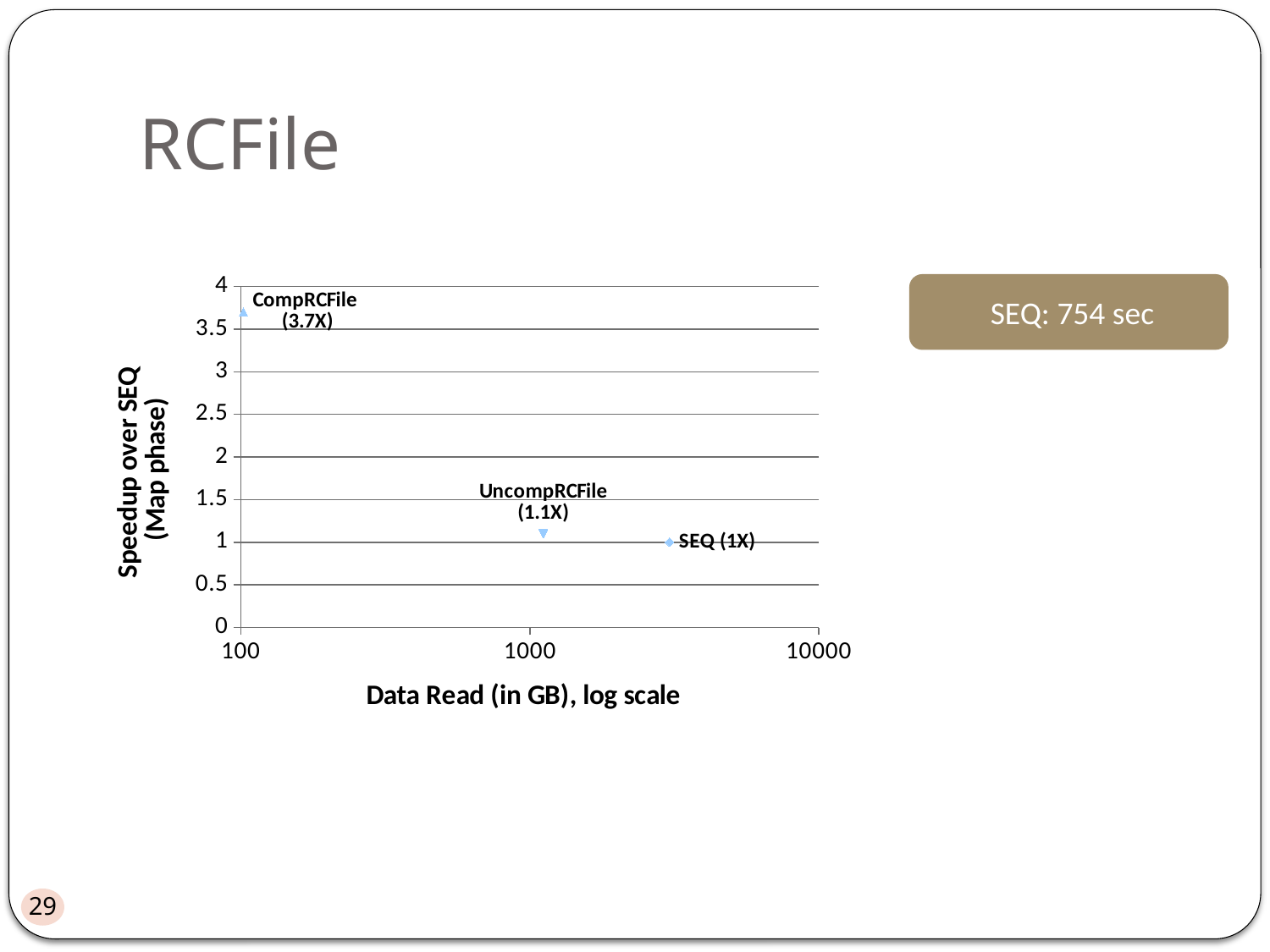
What kind of chart is shown on the slide? scatter chart Is the speedup for CompRCFile greater or less than 3.5? greater Which point has the lowest speedup over SEQ? SEQ Which point has the highest speedup over SEQ? CompRCFile How many data points are plotted on the chart? 3 What speedup over SEQ is labelled for UncompRCFile? 1.1X What speedup is labelled for SEQ? 1X What is the label of the y axis? Speedup over SEQ (Map phase) Is the data read for SEQ greater or less than 1000 GB? greater Which has a larger speedup over SEQ, CompRCFile or UncompRCFile? CompRCFile What is the label of the x axis? Data Read (in GB), log scale What speedup over SEQ is labelled for CompRCFile? 3.7X